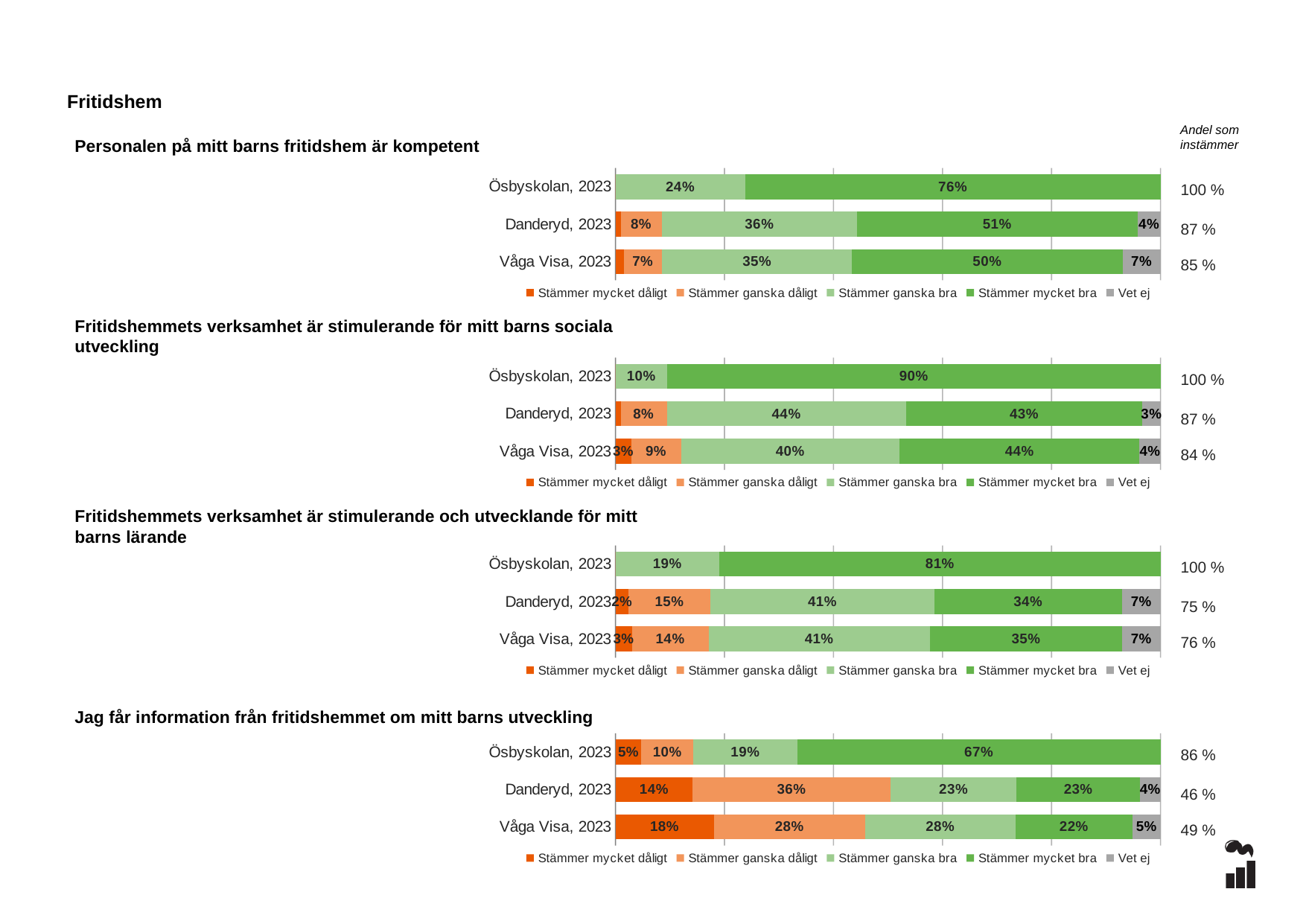
In the chart 'Jag får information från fritidshemmet om mitt barns utveckling', what is the 'Stämmer mycket dåligt' value for Våga Visa, 2023? 18% In the chart 'Fritidshemmets verksamhet är stimulerande och utvecklande för mitt barns lärande', which is larger: the 'Stämmer ganska dåligt' value for Danderyd, 2023 or for Våga Visa, 2023? Danderyd, 2023 In the chart 'Personalen på mitt barns fritidshem är kompetent', what is the 'Vet ej' value for Våga Visa, 2023? 7% How many series does the legend list in the chart 'Personalen på mitt barns fritidshem är kompetent'? 5 In the chart 'Jag får information från fritidshemmet om mitt barns utveckling', which row has the lowest 'Stämmer mycket bra' value? Våga Visa, 2023 In the chart 'Fritidshemmets verksamhet är stimulerande för mitt barns sociala utveckling', what is the 'Stämmer ganska bra' value for Danderyd, 2023? 44% In the chart 'Jag får information från fritidshemmet om mitt barns utveckling', what is the 'Andel som instämmer' value shown for Danderyd, 2023? 46 % In the chart 'Fritidshemmets verksamhet är stimulerande för mitt barns sociala utveckling', which row has the highest 'Stämmer mycket bra' value? Ösbyskolan, 2023 In the chart 'Fritidshemmets verksamhet är stimulerande och utvecklande för mitt barns lärande', what is the difference between the 'Stämmer mycket bra' values for Ösbyskolan, 2023 and Danderyd, 2023? 47 percentage points What kind of chart is used for 'Jag får information från fritidshemmet om mitt barns utveckling'? Stacked bar chart In the chart 'Personalen på mitt barns fritidshem är kompetent', what is the 'Stämmer mycket bra' value for Ösbyskolan, 2023? 76% How many rows (categories) are shown in the chart 'Fritidshemmets verksamhet är stimulerande och utvecklande för mitt barns lärande'? 3